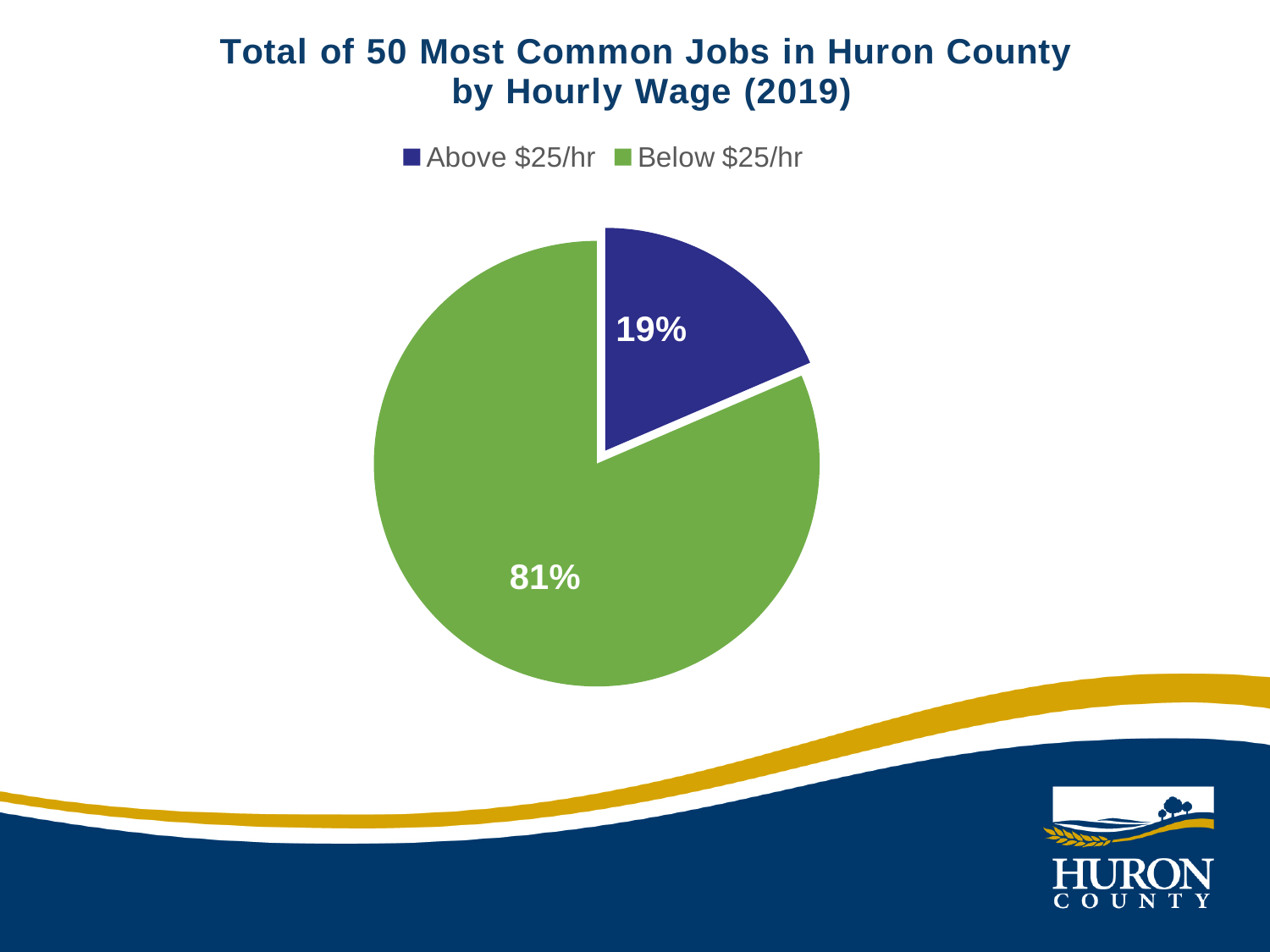
What share of the pie is labelled "Above $25/hr"? 19% How many entries does the legend list? 2 Which category has the largest slice of the pie? Below $25/hr What kind of chart is shown on the slide? Pie chart What is the difference in percentage points between the "Below $25/hr" and "Above $25/hr" slices? 62 How many slices does the pie chart have? 2 What is the title of the chart? Total of 50 Most Common Jobs in Huron County by Hourly Wage (2019) Which category has the smallest slice of the pie? Above $25/hr What colour is the "Below $25/hr" slice? Green What share of the pie is labelled "Below $25/hr"? 81% Which is larger, the "Above $25/hr" slice or the "Below $25/hr" slice? Below $25/hr